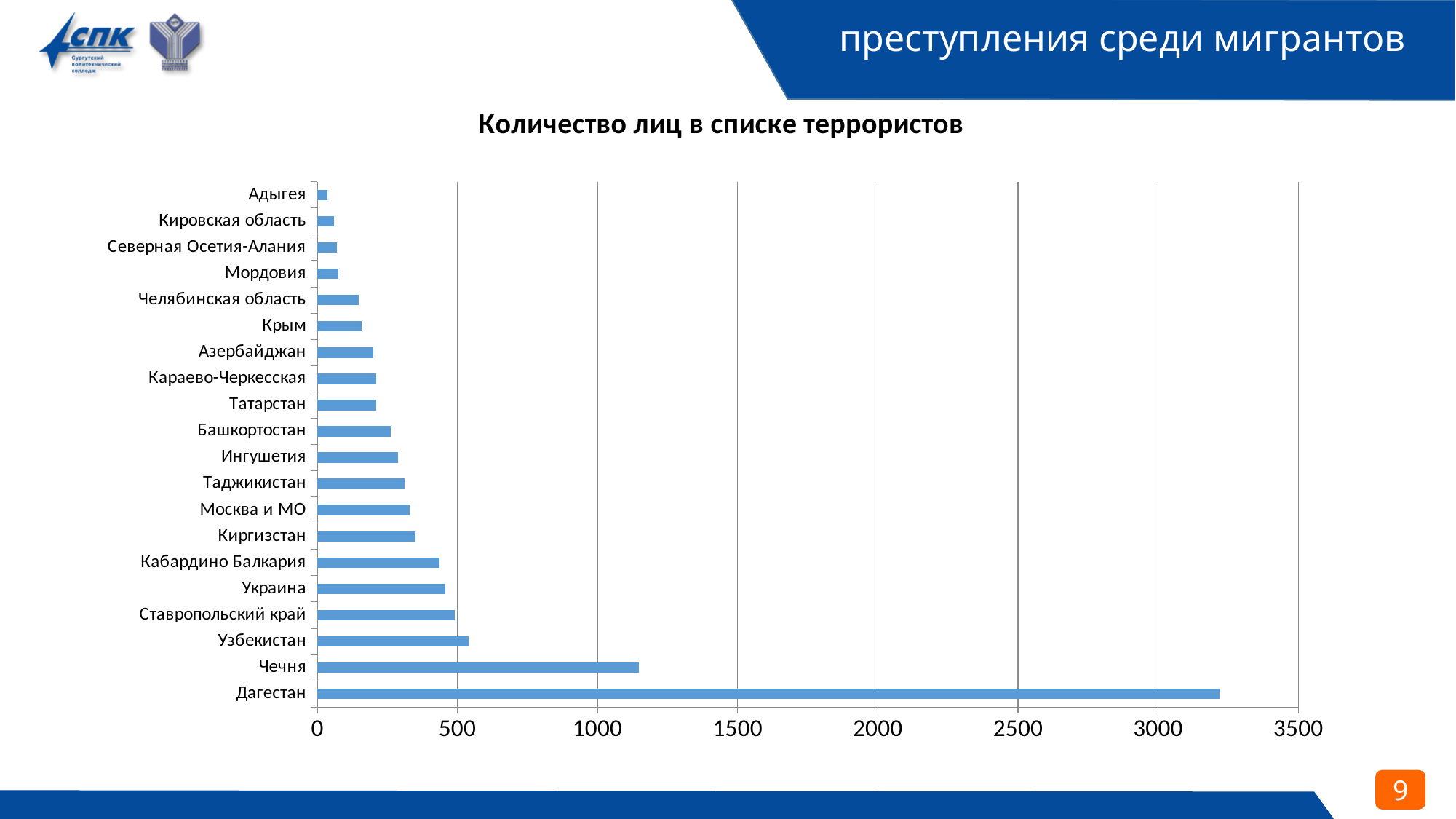
Which category has the lowest value? Адыгея Is the value for Узбекистан greater or less than 500? greater Which is larger, the value for Крым or the value for Кабардино Балкария? Кабардино Балкария What is the highest value shown on the horizontal axis? 3500 Which category has the highest value? Дагестан Which is larger, the value for Чечня or the value for Узбекистан? Чечня What kind of chart is shown on the slide? bar chart Is the value for Украина greater or less than 500? less What is the title of the chart? Количество лиц в списке террористов How many categories are plotted in the chart? 20 Is the value for Чечня greater or less than 1000? greater